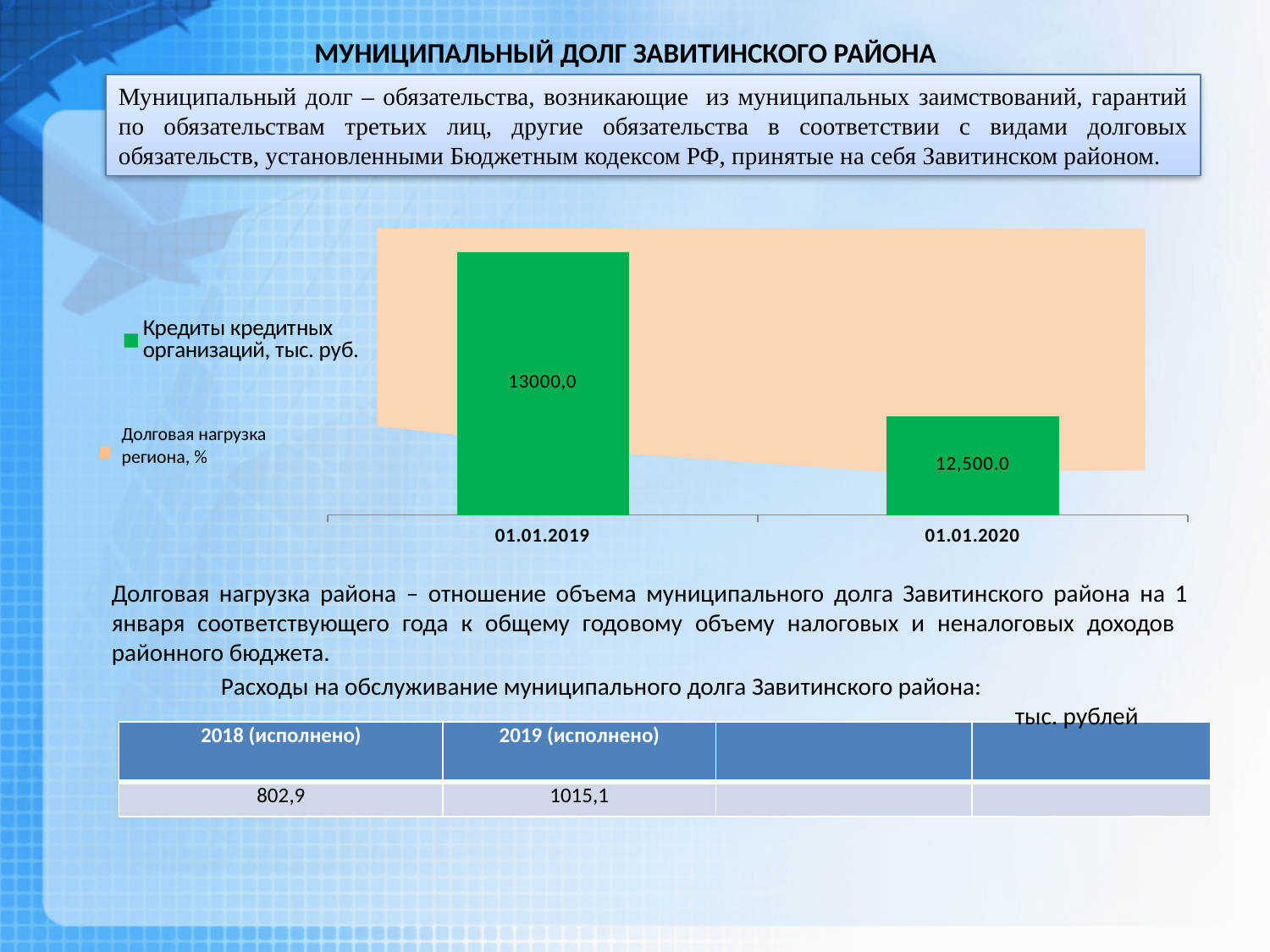
What is the name of the second series listed in the chart legend? Долговая нагрузка региона, % Is the value for Кредиты кредитных организаций larger on 01.01.2019 or on 01.01.2020? 01.01.2019 Which date has the lower value for Кредиты кредитных организаций, тыс. руб.? 01.01.2020 By how much does the value for Кредиты кредитных организаций, тыс. руб. on 01.01.2019 exceed the value on 01.01.2020? 500 What is the value of Кредиты кредитных организаций, тыс. руб. for 01.01.2019? 13000,0 What colour are the bars for Кредиты кредитных организаций, тыс. руб.? green How many series does the chart legend list? 2 Which date has the higher value for Кредиты кредитных организаций, тыс. руб.? 01.01.2019 Do the values for Кредиты кредитных организаций, тыс. руб. rise or fall from 01.01.2019 to 01.01.2020? fall What is the value of Кредиты кредитных организаций, тыс. руб. for 01.01.2020? 12,500.0 How many dates are shown on the x axis of the chart? 2 What kind of chart is used to show Кредиты кредитных организаций, тыс. руб.? bar chart